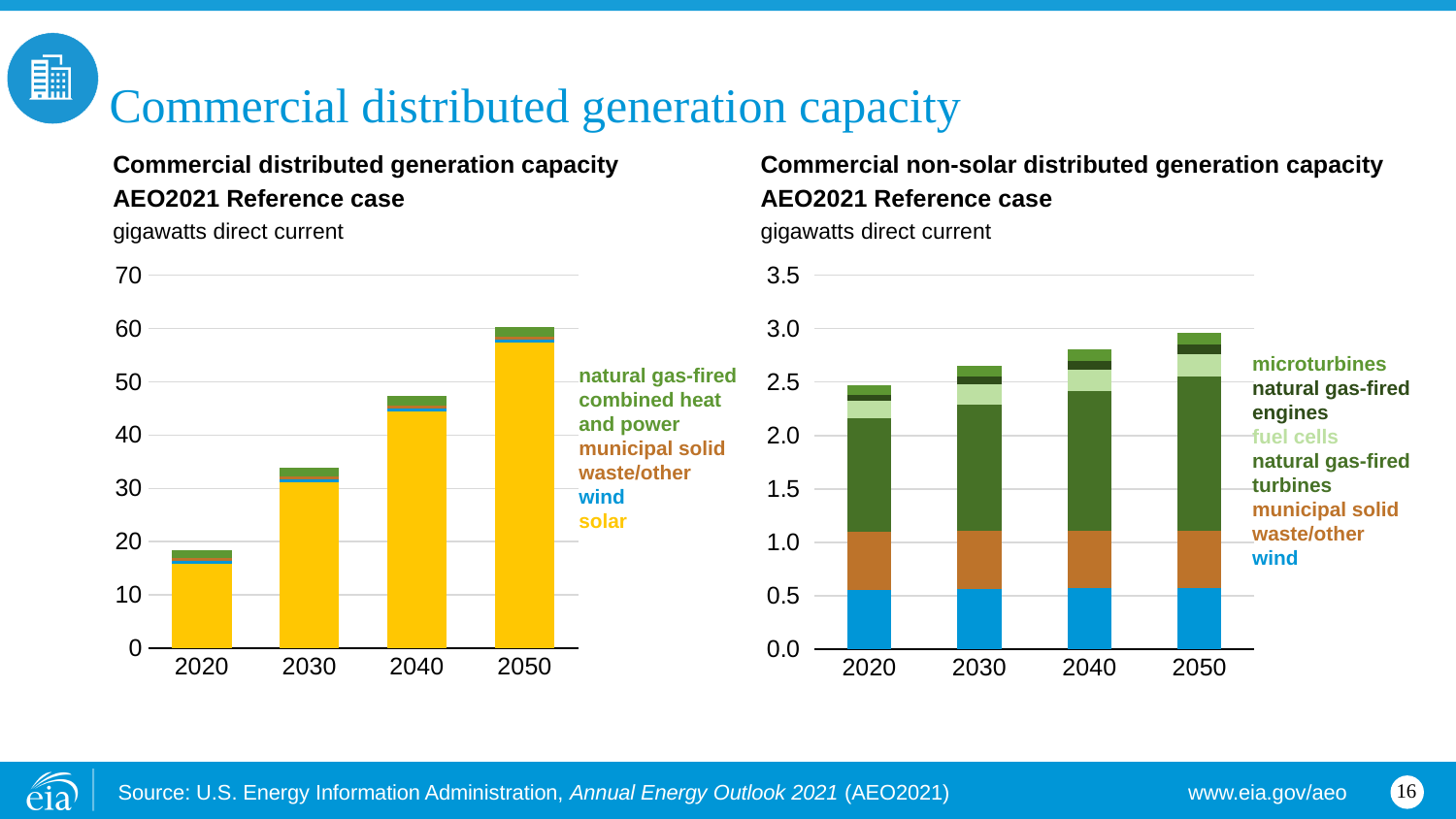
In the left chart, Commercial distributed generation capacity, what kind of chart is used? Stacked bar chart In the right chart, Commercial non-solar distributed generation capacity, which is larger, the total for 2040 or the total for 2020? 2040 In the right chart, Commercial non-solar distributed generation capacity, is the total for 2050 greater or less than 2.5? greater In the left chart, Commercial distributed generation capacity, is the total for 2050 greater or less than 50? greater In the right chart, Commercial non-solar distributed generation capacity, how many series does the legend list? 6 In the left chart, Commercial distributed generation capacity, how many years are shown on the x axis? 4 In the left chart, Commercial distributed generation capacity, do the totals rise or fall from 2020 to 2050? rise In the left chart, Commercial distributed generation capacity, is the total for 2020 greater or less than 20? less In the left chart, Commercial distributed generation capacity, how many series does the legend list? 4 In the left chart, Commercial distributed generation capacity, which year has the highest total capacity? 2050 In the left chart, Commercial distributed generation capacity, which year has the lowest total capacity? 2020 In the left chart, Commercial distributed generation capacity, which series makes up the largest part of each bar? solar